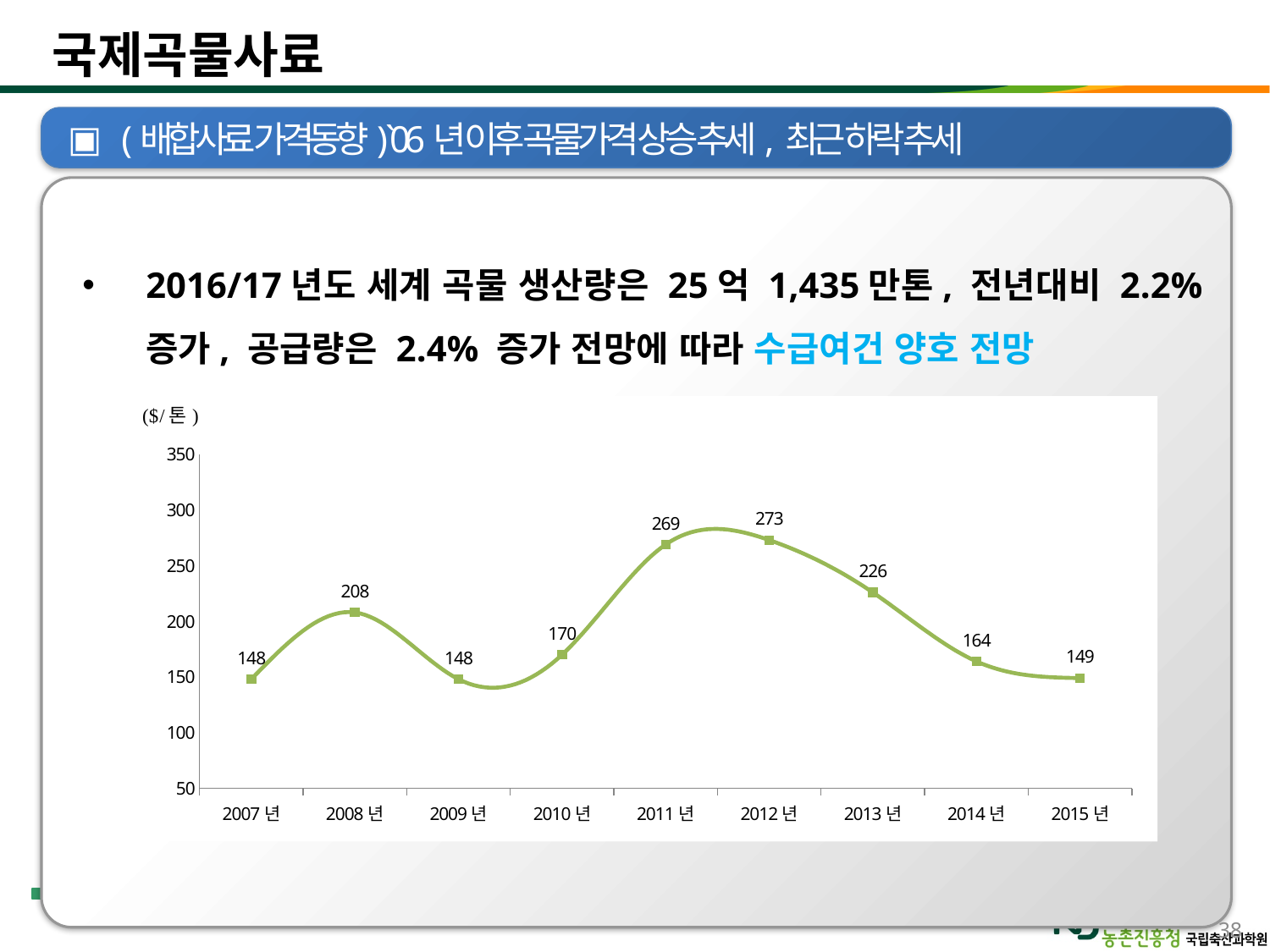
What kind of chart is shown on the slide? line chart What unit is shown on the chart's y axis? $/톤 What is the value for 2015년? 149 Is the value for 2014년 greater or less than 200? less Do the values rise or fall from 2012년 to 2015년? fall How many years are plotted on the chart? 9 What is the difference between the values for 2012년 and 2013년? 47 What is the difference between the values for 2008년 and 2007년? 60 Which year has the highest value? 2012년 Which is larger, the value for 2011년 or the value for 2013년? 2011년 What is the value for 2010년? 170 What is the value for 2012년? 273